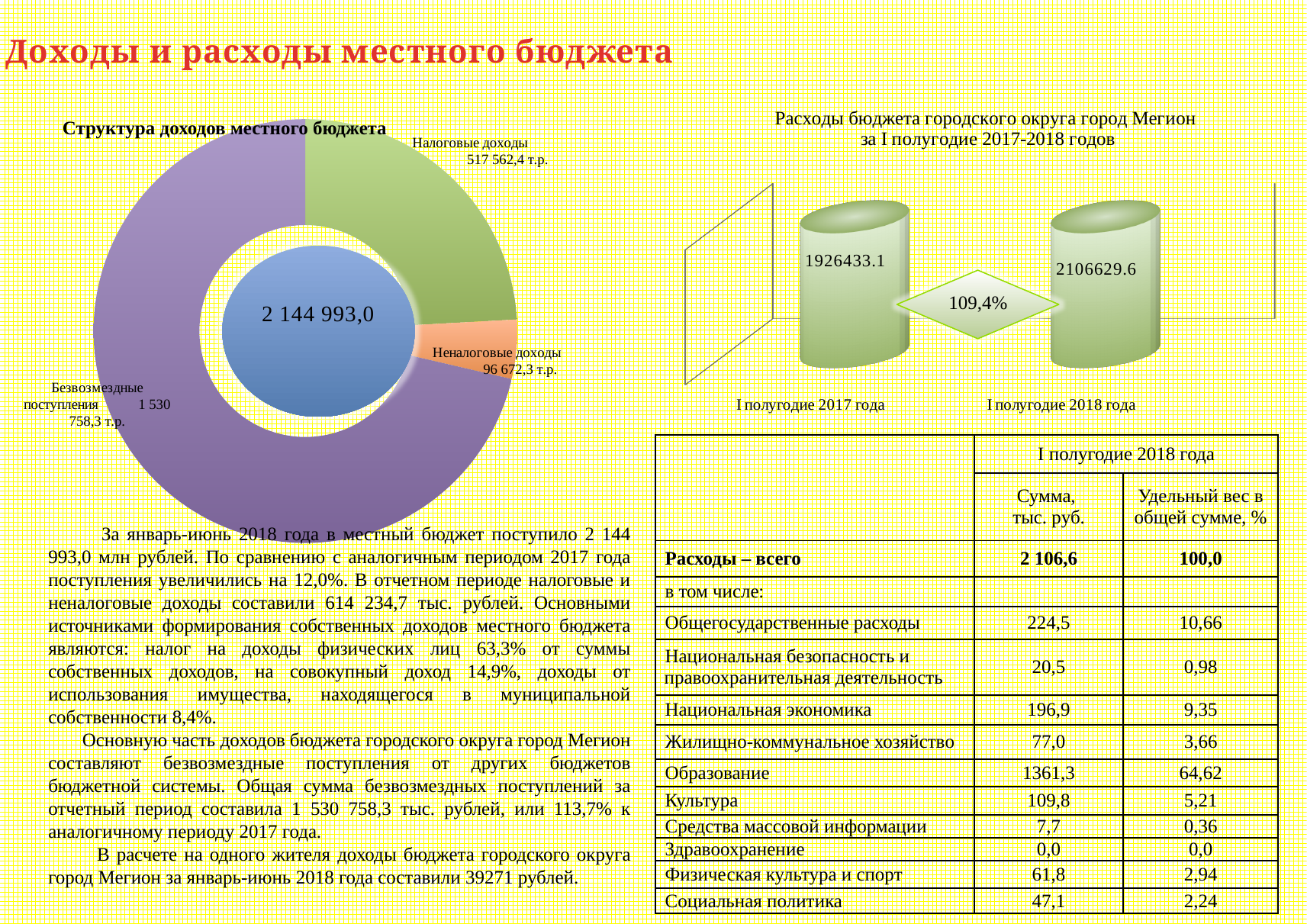
What kind of chart is 'Структура доходов местного бюджета'? Doughnut (pie) chart In the chart 'Структура доходов местного бюджета', what is the value for Налоговые доходы? 517 562,4 т.р. In the chart 'Структура доходов местного бюджета', which category has the smallest value? Неналоговые доходы In the chart 'Структура доходов местного бюджета', what is the value for Безвозмездные поступления? 1 530 758,3 т.р. In the chart 'Структура доходов местного бюджета', which category has the largest value? Безвозмездные поступления In the chart 'Структура доходов местного бюджета', what is the difference between Безвозмездные поступления and Налоговые доходы? 1 013 195,9 т.р. In the chart 'Структура доходов местного бюджета', what is the value for Неналоговые доходы? 96 672,3 т.р. In the chart 'Расходы бюджета городского округа город Мегион за I полугодие 2017-2018 годов', what is the difference between I полугодие 2018 года and I полугодие 2017 года? 180196.5 In the chart 'Структура доходов местного бюджета', what total value is shown in the centre of the doughnut? 2 144 993,0 In the chart 'Расходы бюджета городского округа город Мегион за I полугодие 2017-2018 годов', what is the value for I полугодие 2018 года? 2106629.6 In the chart 'Структура доходов местного бюджета', how many categories are shown? 3 In the chart 'Расходы бюджета городского округа город Мегион за I полугодие 2017-2018 годов', what percentage is shown in the diamond between the two bars? 109,4%